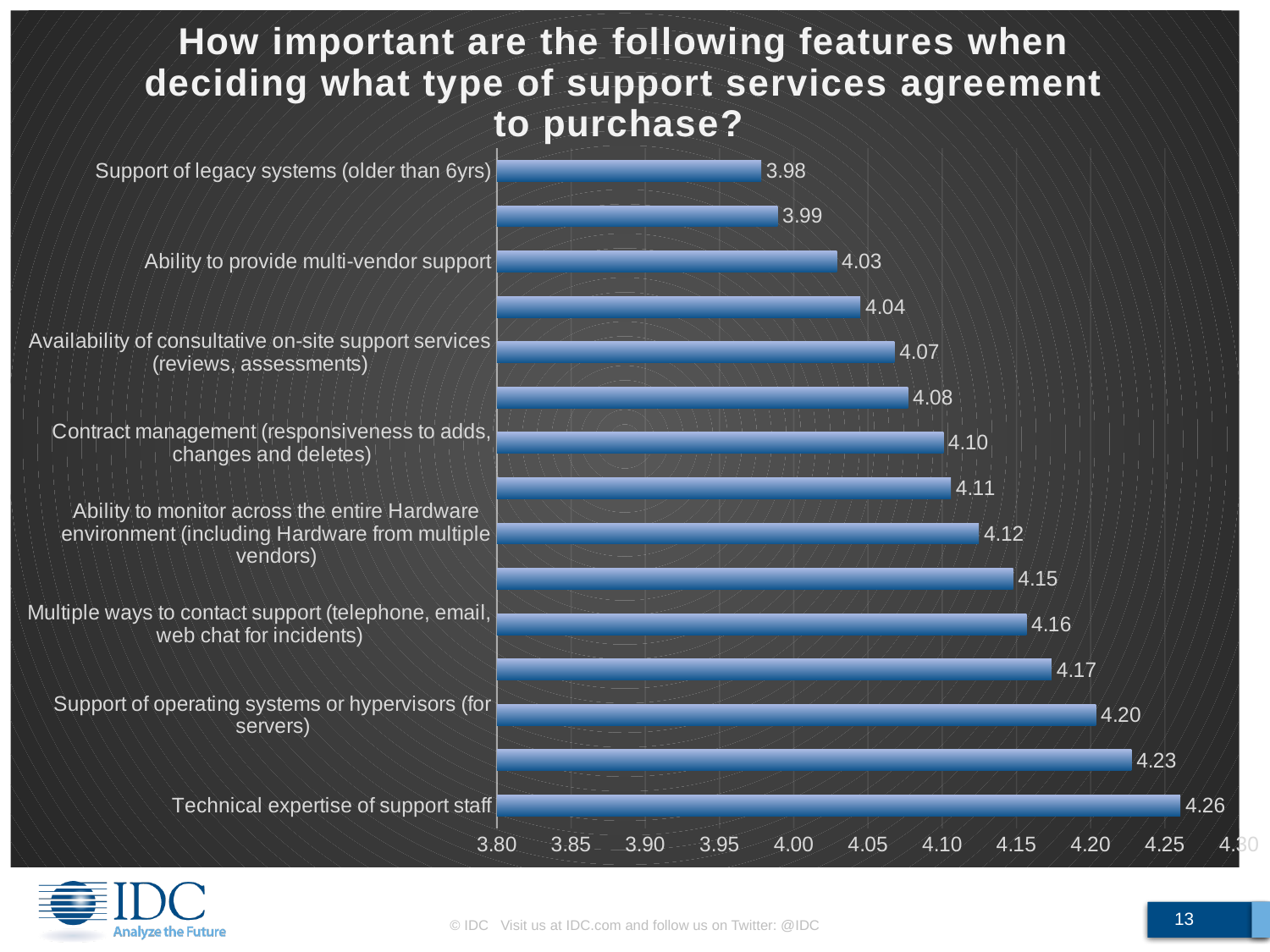
What is the value for Technical expertise of support staff? 4.26 Which feature has the lowest importance value? Support of legacy systems (older than 6yrs) Which feature has the highest importance value? Technical expertise of support staff What is the value for Multiple ways to contact support (telephone, email, web chat for incidents)? 4.16 What is the value for Contract management (responsiveness to adds, changes and deletes)? 4.10 What is the difference between the values for Technical expertise of support staff and Support of legacy systems (older than 6yrs)? 0.28 Which has a larger value: Support of operating systems or hypervisors (for servers) or Availability of consultative on-site support services (reviews, assessments)? Support of operating systems or hypervisors (for servers) What is the title of the chart? How important are the following features when deciding what type of support services agreement to purchase? How many bars are plotted in the chart? 15 What is the value for Support of legacy systems (older than 6yrs)? 3.98 What is the value for Ability to provide multi-vendor support? 4.03 What kind of chart is shown on the slide? Bar chart